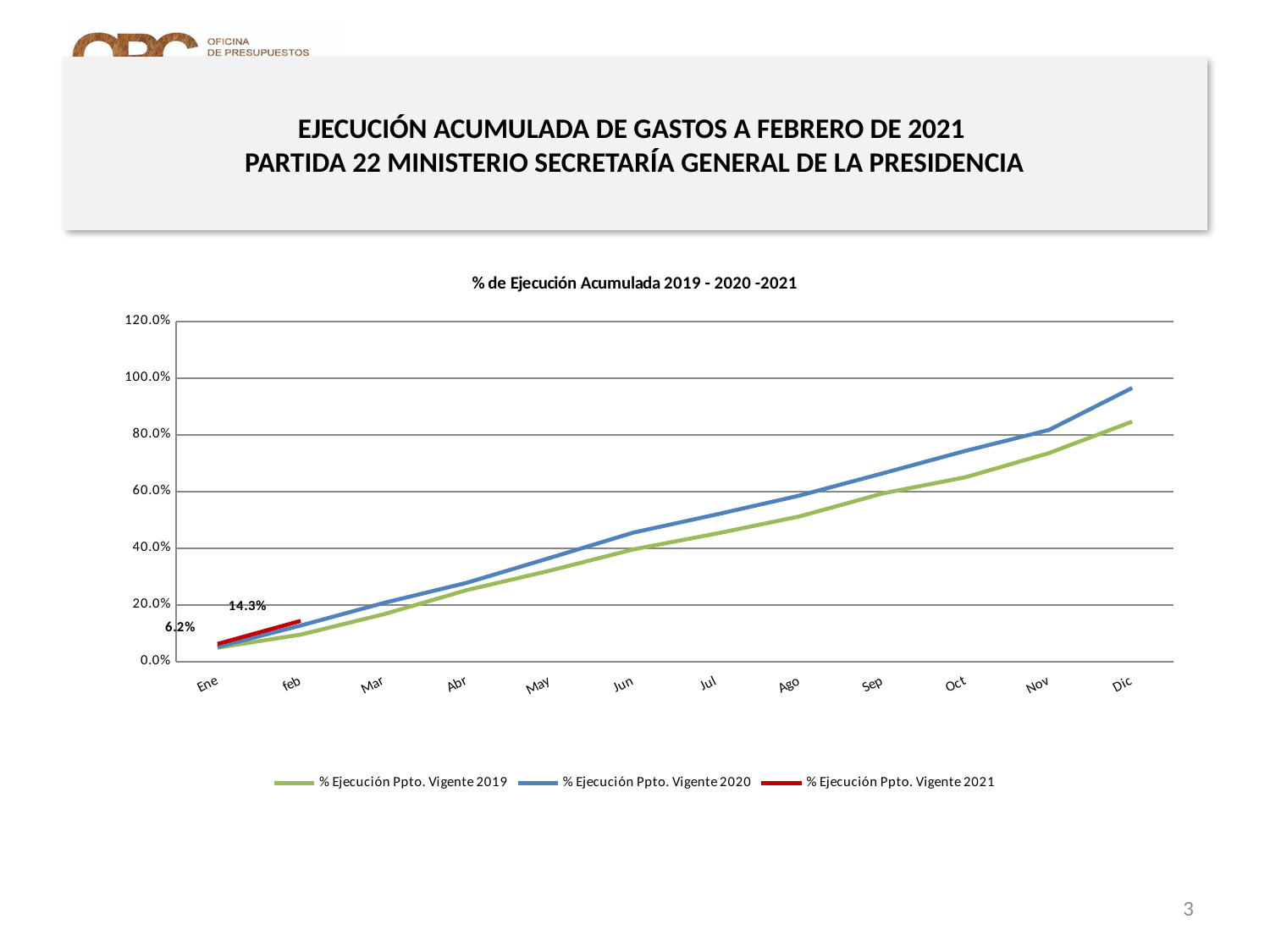
What kind of chart is shown on the slide? line chart What is the title of the chart? % de Ejecución Acumulada 2019 - 2020 -2021 What is the value for % Ejecución Ppto. Vigente 2021 in feb? 14.3% How many months are shown on the x axis? 12 How many series does the legend list? 3 Is the value for % Ejecución Ppto. Vigente 2019 in Dic greater or less than 100.0%? less Does the % Ejecución Ppto. Vigente 2020 line rise or fall from Ene to Dic? rise In Dic, which series has the higher value, % Ejecución Ppto. Vigente 2019 or % Ejecución Ppto. Vigente 2020? % Ejecución Ppto. Vigente 2020 What is the difference between the feb and Ene values for % Ejecución Ppto. Vigente 2021? 8.1% Is the value for % Ejecución Ppto. Vigente 2020 in Dic greater or less than 80.0%? greater What is the value for % Ejecución Ppto. Vigente 2021 in Ene? 6.2% Is the value for % Ejecución Ppto. Vigente 2019 in Jun greater or less than 60.0%? less